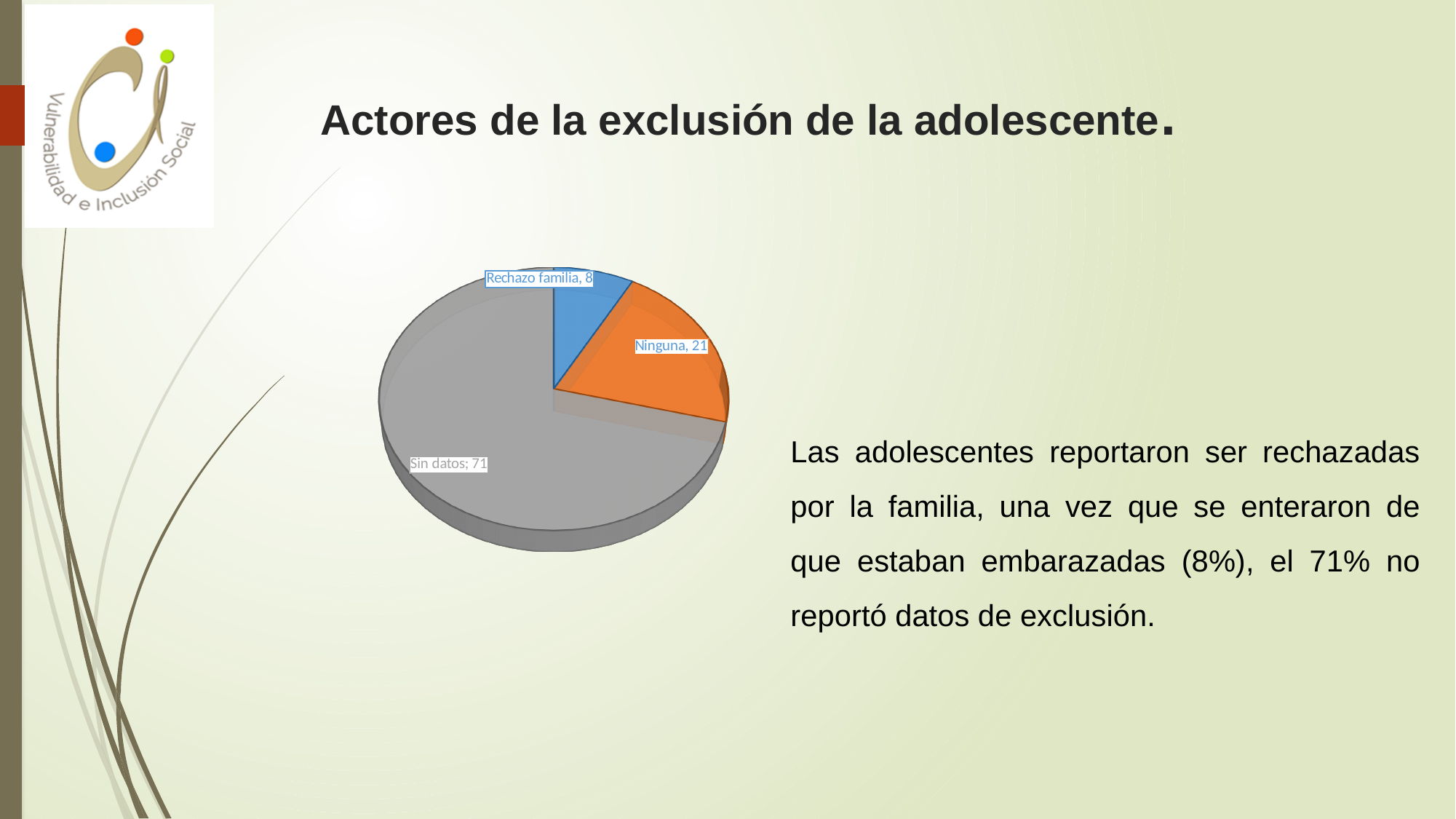
What is the value for Rechazo familia? 8 Which slice has the lowest value? Rechazo familia What is the difference between the values for Ninguna and Rechazo familia? 13 Which is larger, the value for Ninguna or the value for Rechazo familia? Ninguna How many slices does the pie chart have? 3 Which slice has the highest value? Sin datos What colour is the Ninguna slice? orange What is the difference between the values for Sin datos and Ninguna? 50 What is the total of all slices in the pie chart? 100 What is the value for Ninguna? 21 What kind of chart is shown on the slide? pie chart What is the value for Sin datos? 71